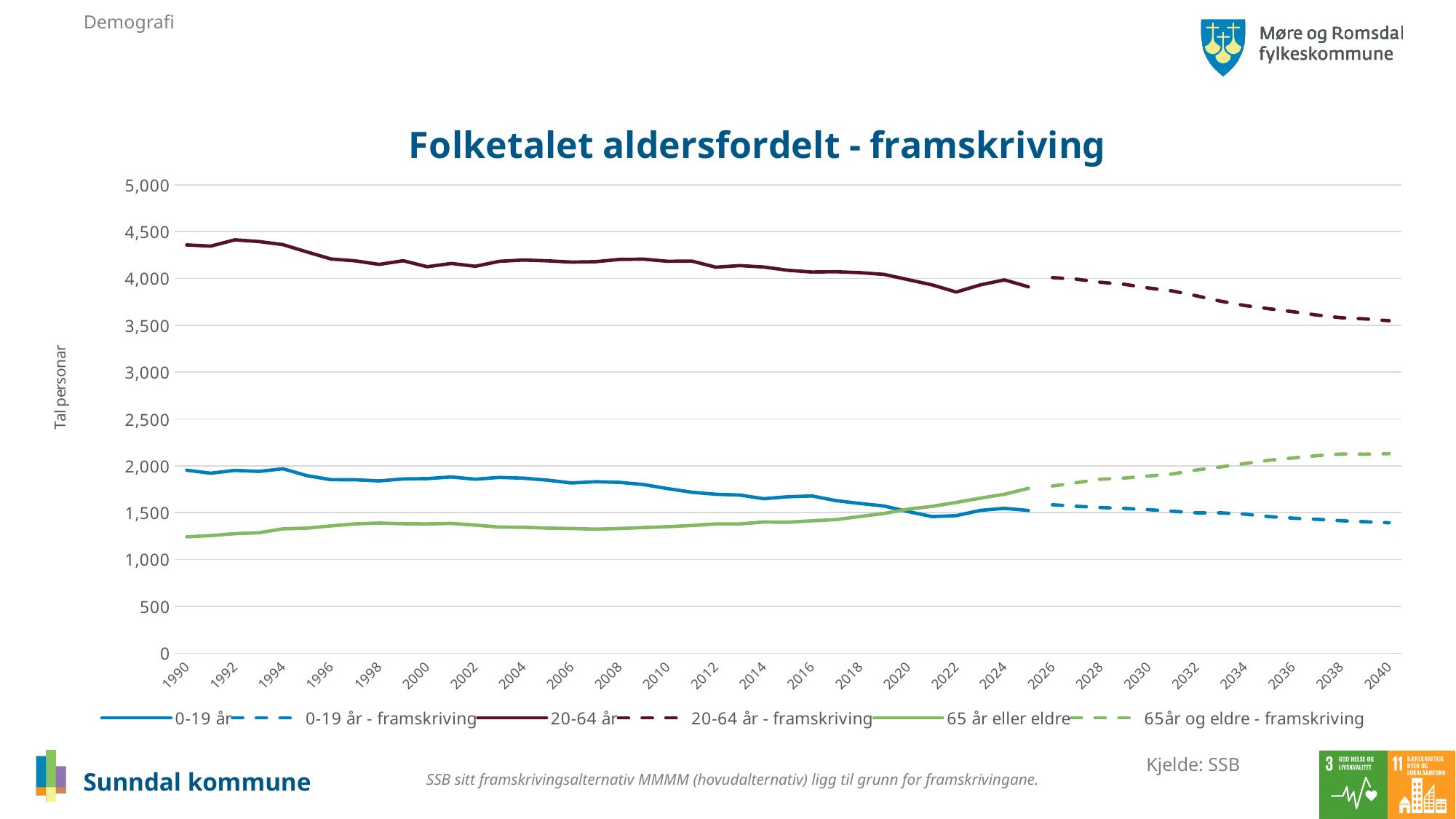
Does the 20-64 år - framskriving series rise or fall from 2026 to 2040? fall What kind of chart is shown on the slide? line chart Does the 65år og eldre - framskriving series rise or fall from 2026 to 2040? rise In 2040, which is higher: 65år og eldre - framskriving or 0-19 år - framskriving? 65år og eldre - framskriving What is the label on the vertical axis? Tal personar What is the title of the chart? Folketalet aldersfordelt - framskriving Is the value for 20-64 år in 1990 greater or less than 4,000? greater Is the value for 20-64 år - framskriving in 2040 greater or less than 4,000? less Which age group series has the highest values across the whole chart? 20-64 år How many series does the legend list? 6 Is the value for 65 år eller eldre in 1990 greater or less than 1,500? less